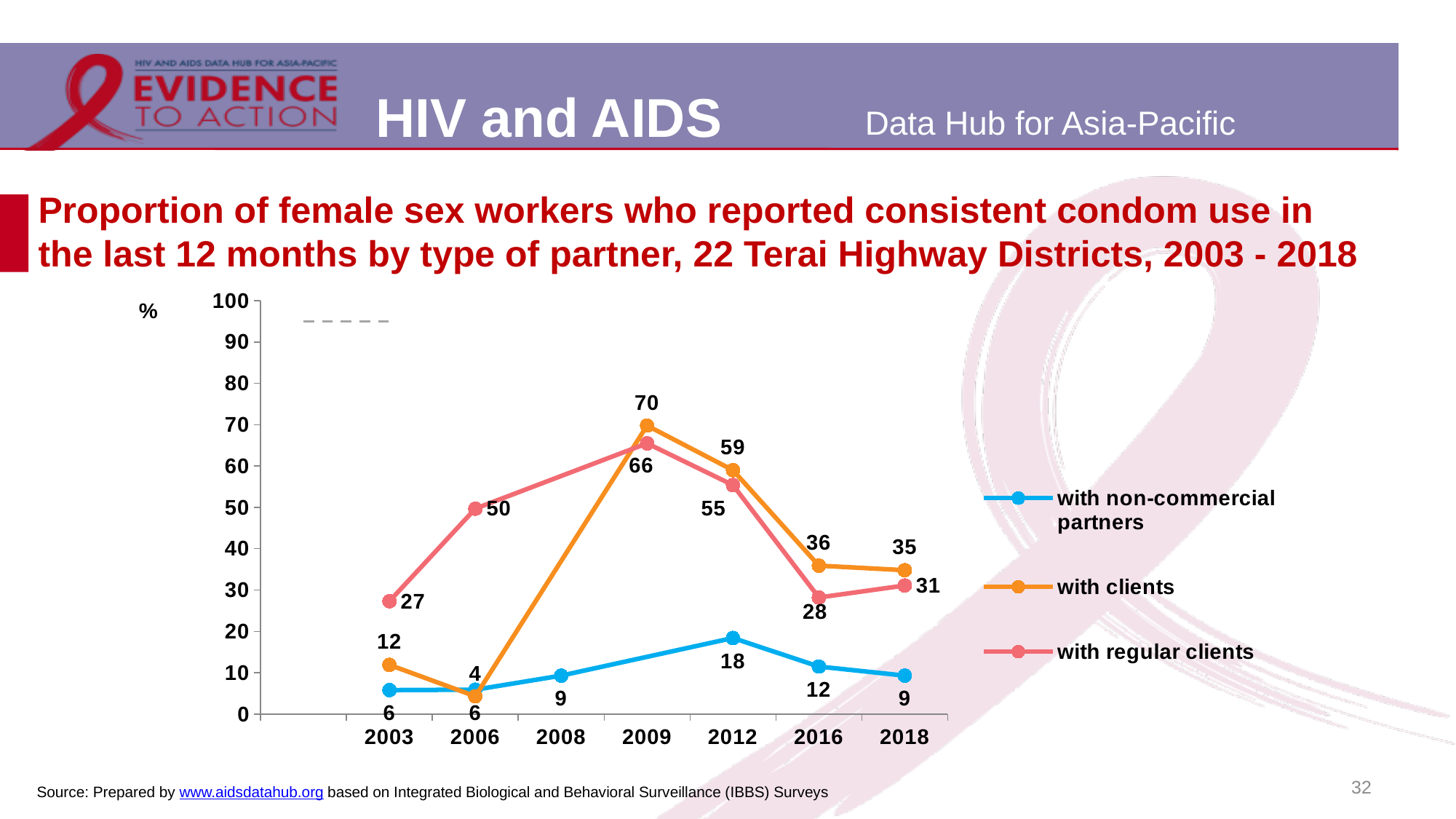
In which year is the value for 'with clients' lowest? 2006 How many years are shown on the x axis? 7 How many series does the legend list? 3 What is the difference between 'with clients' and 'with regular clients' in 2012? 4 What value is shown for 'with non-commercial partners' in 2012? 18 In 2016, which is larger: 'with clients' or 'with regular clients'? with clients What value is shown for 'with regular clients' in 2018? 31 What value is shown for 'with clients' in 2009? 70 What kind of chart is shown on the slide? line chart What value is shown for 'with regular clients' in 2006? 50 In which year is the value for 'with clients' highest? 2009 What is the difference between the 'with clients' values in 2018 and 2003? 23